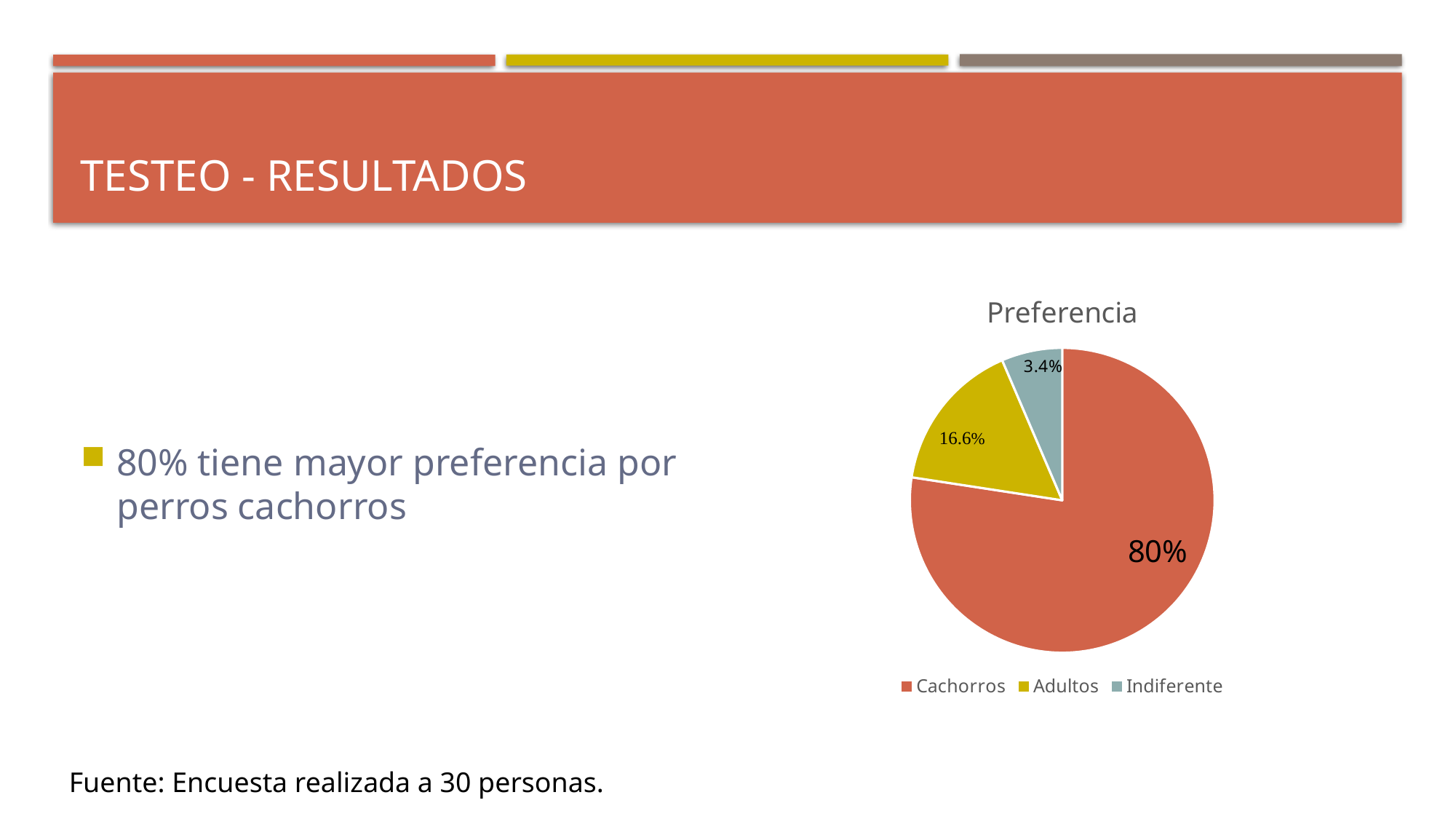
Which is larger, the slice for Adultos or the slice for Indiferente? Adultos What share of the pie does Indiferente have? 3.4% What kind of chart is shown on the slide? pie chart What share of the pie does Adultos have? 16.6% Which colour represents Adultos in the legend? yellow What is the difference between the Adultos share and the Indiferente share? 13.2% Which category has the smallest slice of the pie? Indiferente What is the difference between the Cachorros share and the Adultos share? 63.4% What is the title of the chart? Preferencia Which category has the largest slice of the pie? Cachorros How many categories does the pie chart show? 3 What share of the pie does Cachorros have? 80%